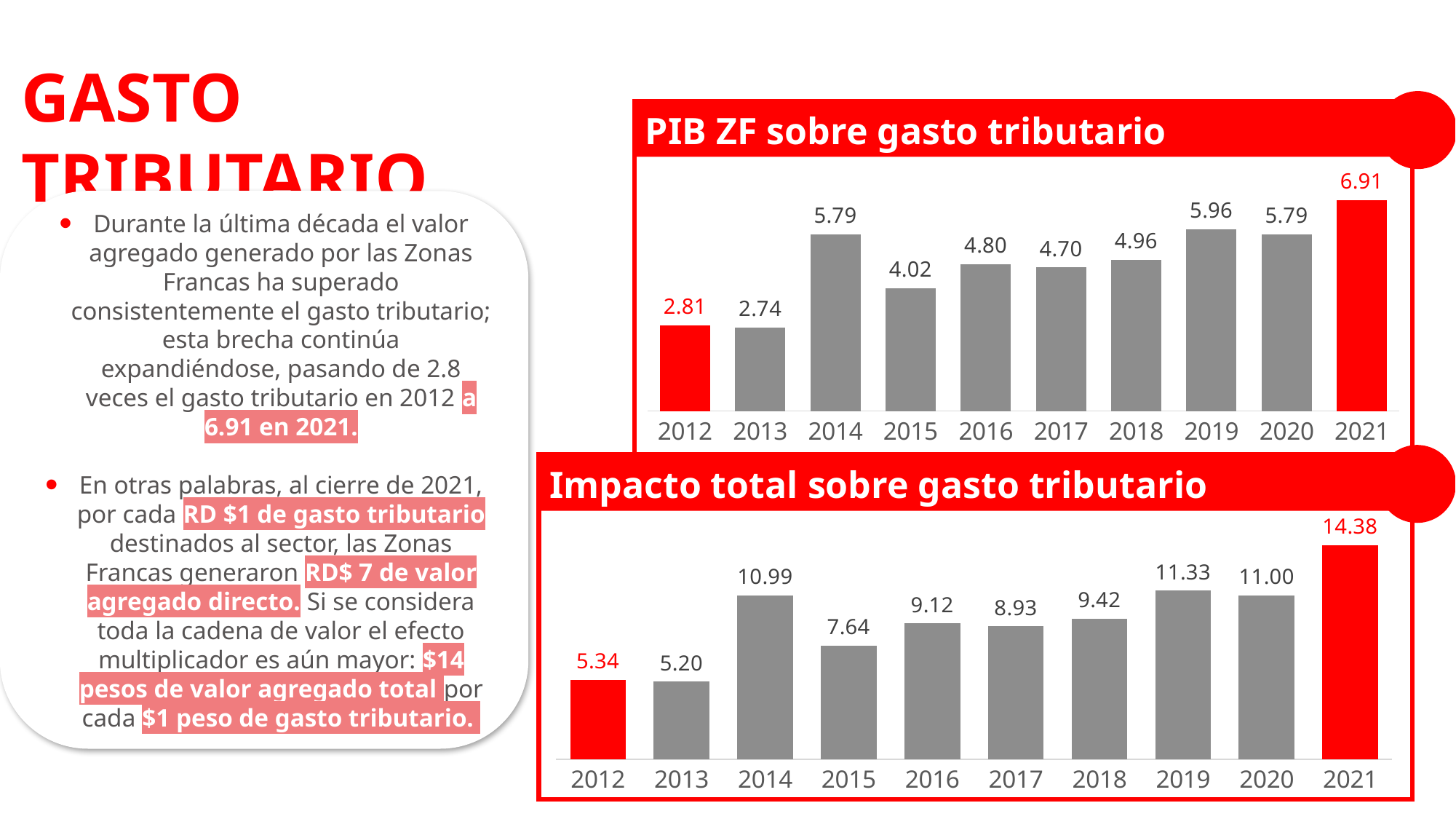
How many years are shown in the 'PIB ZF sobre gasto tributario' chart? 10 In the 'Impacto total sobre gasto tributario' chart, do the values rise or fall from 2019 to 2020? Fall In the 'Impacto total sobre gasto tributario' chart, which year has the highest value? 2021 In the 'PIB ZF sobre gasto tributario' chart, which years have red bars? 2012 and 2021 In the 'PIB ZF sobre gasto tributario' chart, which year has the lowest value? 2013 What type of chart is 'Impacto total sobre gasto tributario'? Bar chart In the 'Impacto total sobre gasto tributario' chart, what is the difference between the 2014 value and the 2015 value? 3.35 In the 'PIB ZF sobre gasto tributario' chart, what is the value for 2021? 6.91 In the 'PIB ZF sobre gasto tributario' chart, which is larger, the value for 2016 or the value for 2017? 2016 In the 'Impacto total sobre gasto tributario' chart, which is larger, the value for 2012 or the value for 2013? 2012 In the 'PIB ZF sobre gasto tributario' chart, what is the difference between the 2021 value and the 2012 value? 4.10 In the 'Impacto total sobre gasto tributario' chart, what is the value for 2019? 11.33